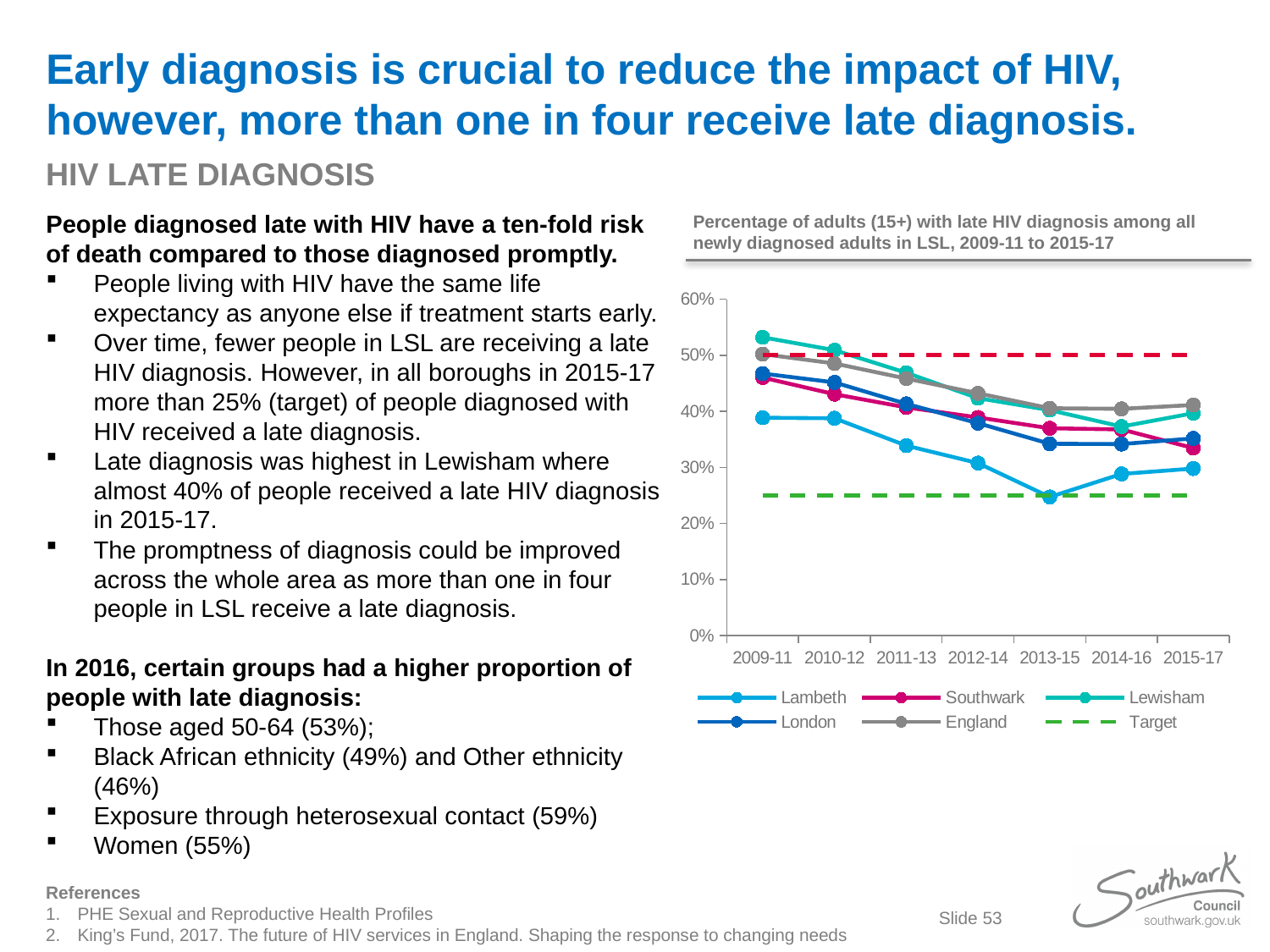
What kind of chart is shown on the slide? line chart Which series had the lowest percentage of late HIV diagnosis in 2013-15? Lambeth In 2009-11, which had a higher percentage of late HIV diagnosis, Lewisham or Lambeth? Lewisham Is the value for Lewisham in 2009-11 greater or less than 50%? greater How many time periods are shown along the x axis of the chart? 7 Which series had the lowest percentage of late HIV diagnosis in 2009-11? Lambeth Which legend entry is drawn as a green dashed line? Target Does the Lewisham line generally rise or fall from 2009-11 to 2015-17? fall Is the value for Lambeth in 2013-15 greater or less than 30%? less Which series had the highest percentage of late HIV diagnosis in 2009-11? Lewisham How many series does the chart legend list? 6 Is the value for Lewisham in 2012-14 greater or less than 40%? greater